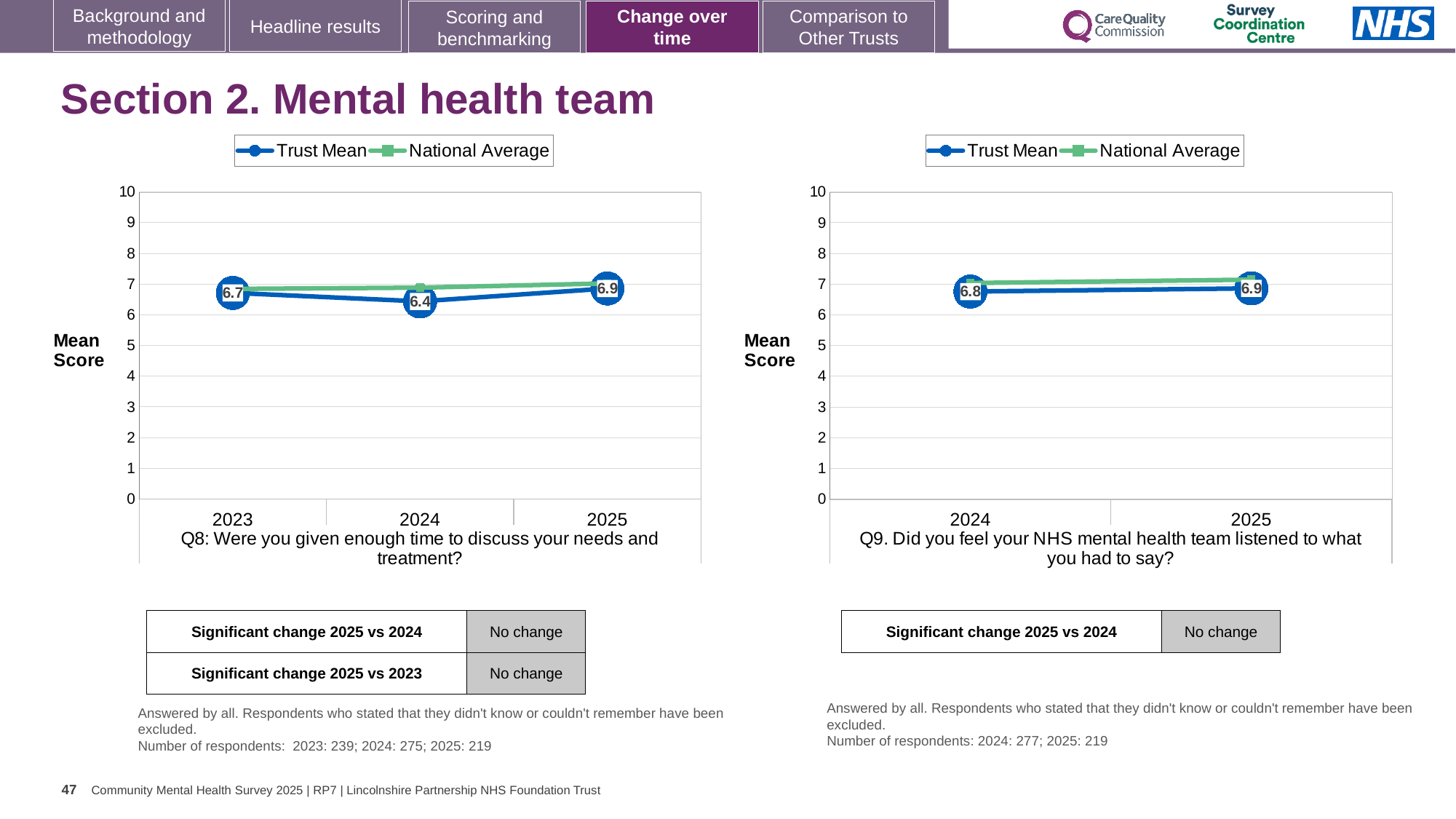
In the Q9 chart (right), what is the Trust Mean for 2024? 6.8 In the Q9 chart (right), what is the difference between the Trust Mean for 2025 and 2024? 0.1 In the Q8 chart (left), which year has the highest Trust Mean? 2025 How many series does the legend of the Q8 chart (left) list? 2 What kind of chart is the Q9 chart (right)? Line chart In the Q8 chart (left), what is the Trust Mean for 2025? 6.9 In the Q8 chart (left), is the Trust Mean for 2023 greater or less than the Trust Mean for 2024? greater In the Q8 chart (left), what is the Trust Mean for 2024? 6.4 In the Q8 chart (left), is the National Average for 2025 greater or less than 6? greater How many years are shown on the x axis of the Q9 chart (right)? 2 In the Q8 chart (left), what is the difference between the Trust Mean for 2025 and 2024? 0.5 In the Q8 chart (left), which year has the lowest Trust Mean? 2024